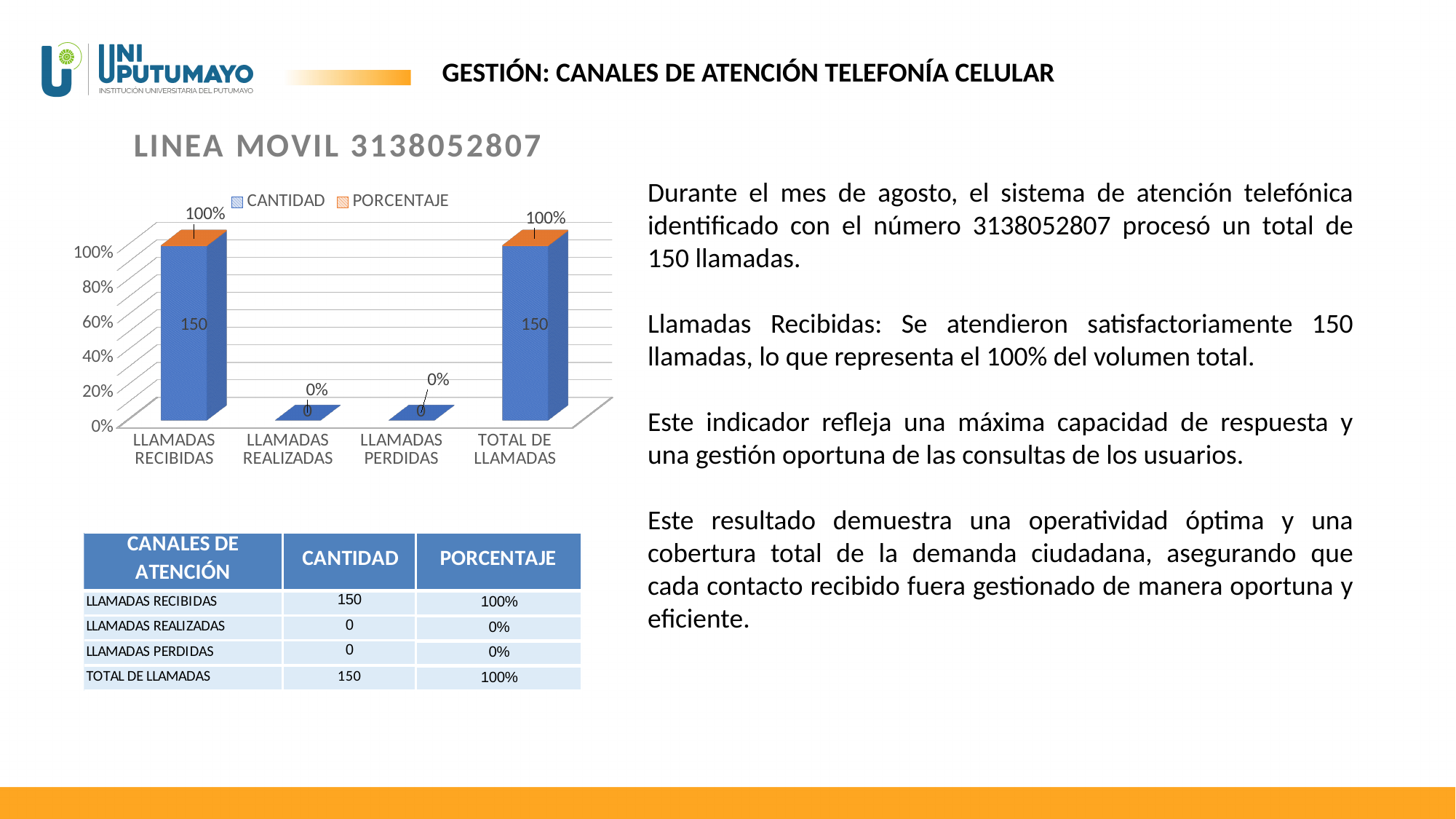
What is the title of the chart? LINEA MOVIL 3138052807 What kind of chart is shown on the slide? Bar chart Which category has the lowest PORCENTAJE value, LLAMADAS RECIBIDAS or LLAMADAS PERDIDAS? LLAMADAS PERDIDAS How many categories are shown on the x axis of the chart? 4 How many series does the chart legend list? 2 What is the CANTIDAD value for LLAMADAS PERDIDAS in the chart? 0 What is the CANTIDAD value for LLAMADAS RECIBIDAS in the chart? 150 Which series in the chart is shown in orange? PORCENTAJE What is the PORCENTAJE value for TOTAL DE LLAMADAS in the chart? 100% What is the difference between the CANTIDAD values for LLAMADAS RECIBIDAS and LLAMADAS REALIZADAS? 150 Is the CANTIDAD value for LLAMADAS RECIBIDAS greater or less than the CANTIDAD value for LLAMADAS PERDIDAS? greater What is the PORCENTAJE value for LLAMADAS REALIZADAS in the chart? 0%